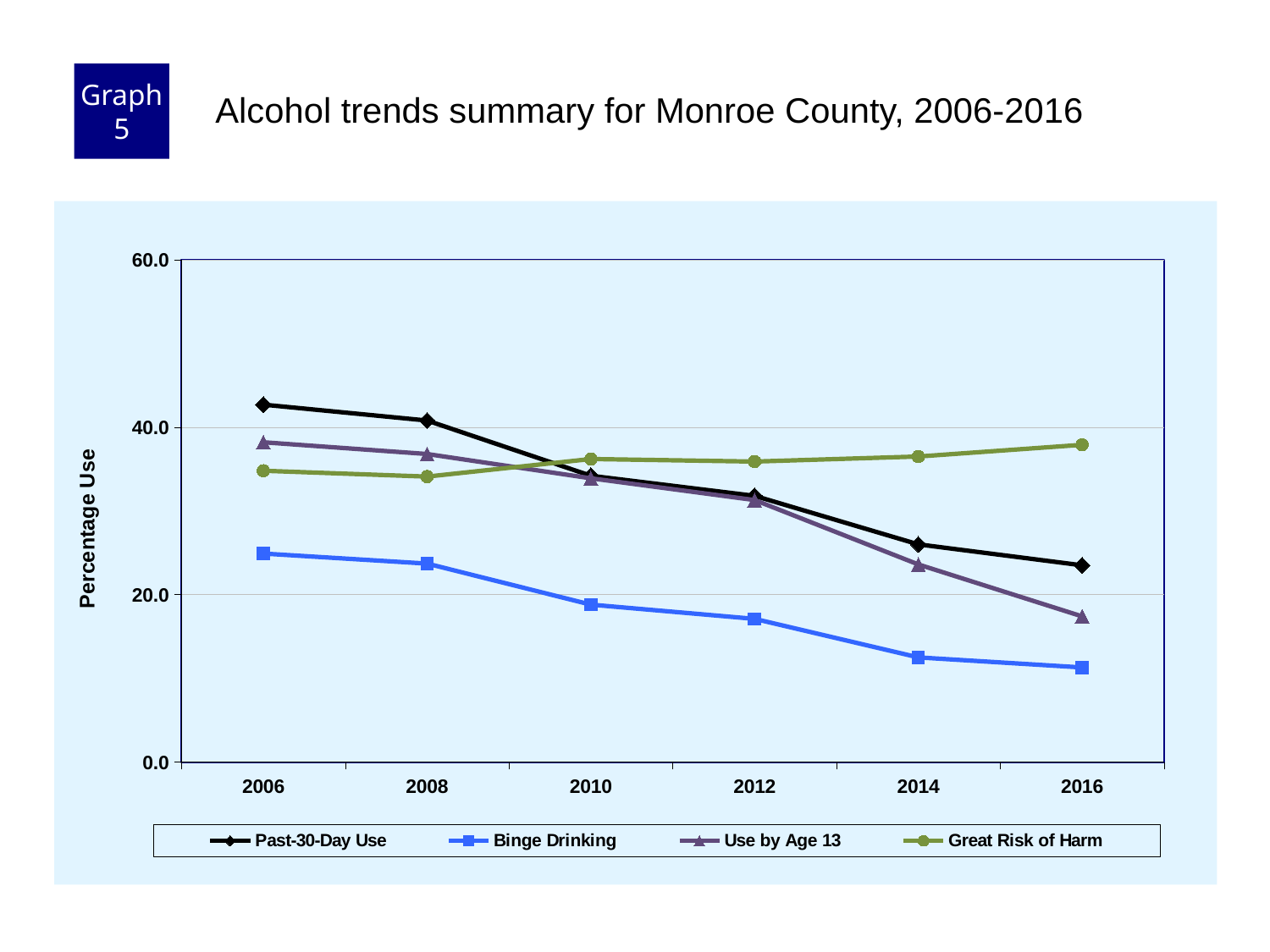
Which series has the highest value in 2016? Great Risk of Harm In 2006, which is larger: Past-30-Day Use or Great Risk of Harm? Past-30-Day Use What is the label on the vertical axis? Percentage Use What kind of chart is shown on the slide? Line chart Does the Great Risk of Harm line rise or fall from 2006 to 2016? Rise How many series does the legend list? 4 Is the value for Use by Age 13 in 2016 greater or less than 20.0? less Does the Binge Drinking line rise or fall from 2006 to 2016? Fall Is the value for Binge Drinking in 2016 greater or less than 20.0? less Is the value for Past-30-Day Use in 2006 greater or less than 40.0? greater Which series has the lowest value in 2006? Binge Drinking How many years are plotted along the x axis? 6